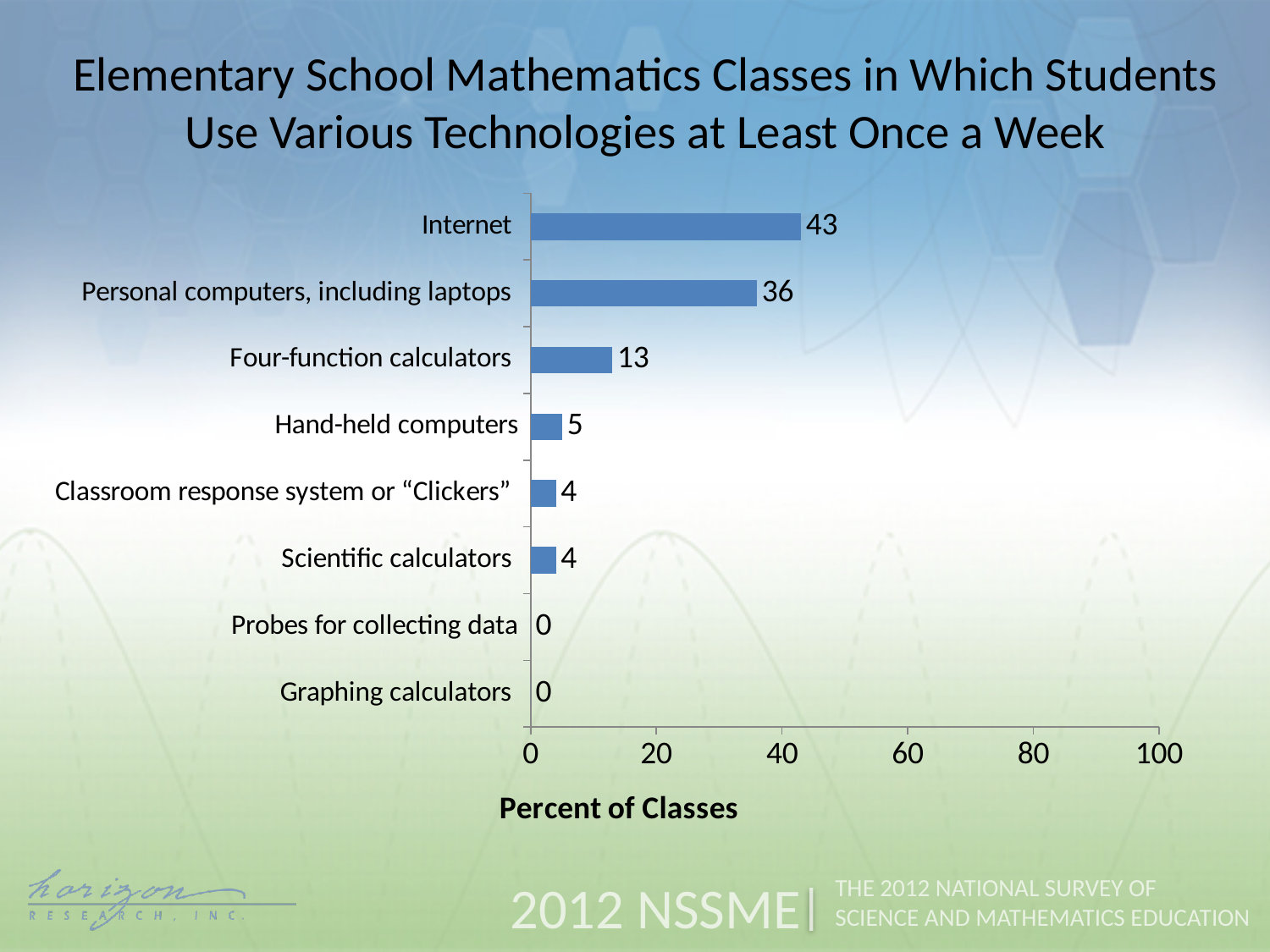
What is the difference between the values for Personal computers, including laptops and Four-function calculators? 23 Which technology has the highest percent of classes? Internet How many categories have a value of 0? 2 What is the difference between the values for Internet and Personal computers, including laptops? 7 Is the value for Internet greater or less than 40? greater What kind of chart is shown on the slide? Bar chart What is the value for Hand-held computers? 5 What is the value for Four-function calculators? 13 How many technology categories are shown in the chart? 8 What is the label of the horizontal axis? Percent of Classes What percent of classes use the Internet at least once a week? 43 Which is larger, the value for Four-function calculators or the value for Hand-held computers? Four-function calculators